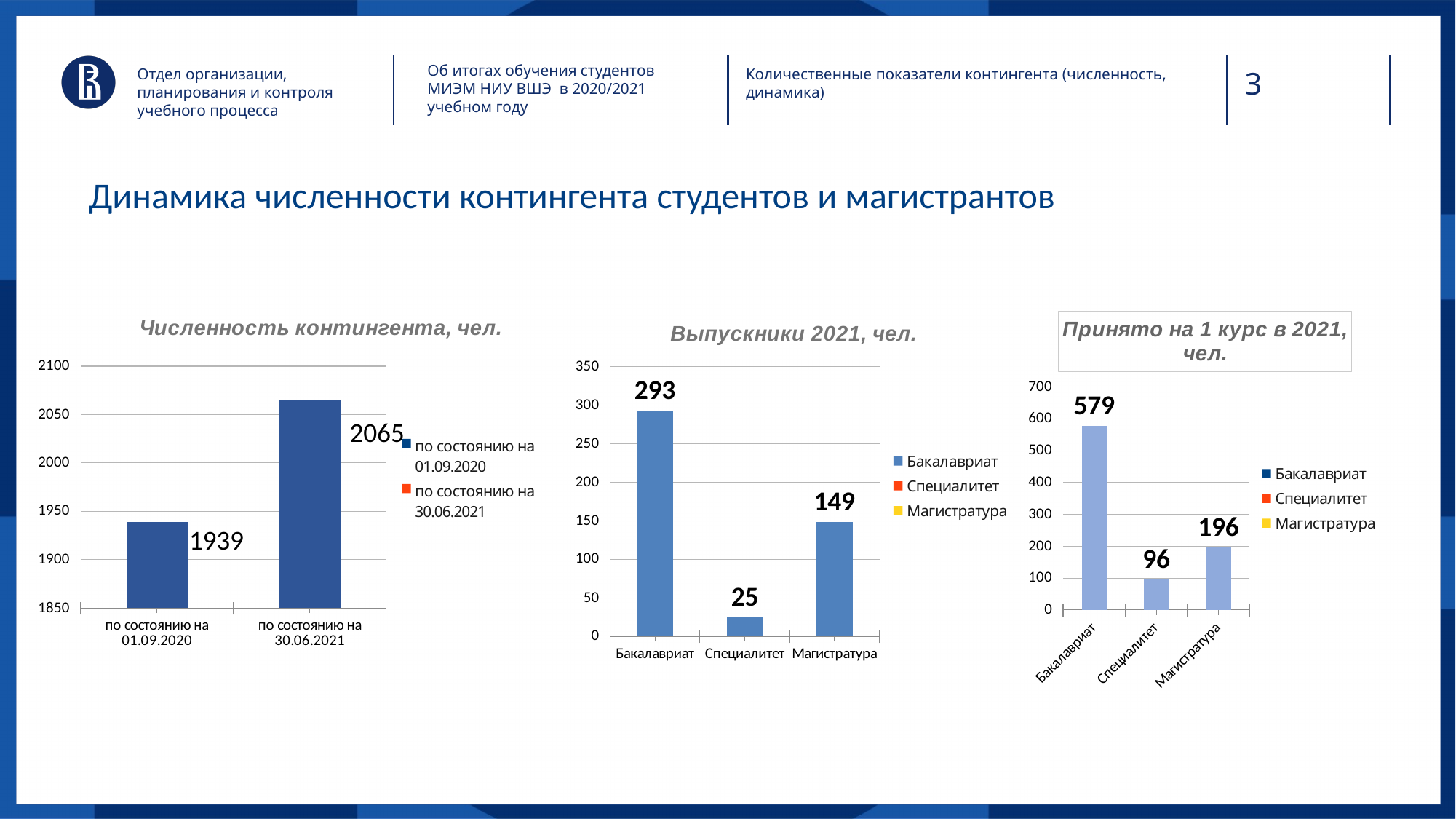
In the chart 'Принято на 1 курс в 2021, чел.', which category has the highest value? Бакалавриат In the chart 'Численность контингента, чел.', do the values rise or fall from 01.09.2020 to 30.06.2021? rise In the chart 'Численность контингента, чел.', what is the value for 'по состоянию на 30.06.2021'? 2065 In the chart 'Принято на 1 курс в 2021, чел.', how many entries does the legend list? 3 In the chart 'Выпускники 2021, чел.', which category has the lowest value? Специалитет In the chart 'Выпускники 2021, чел.', what is the value for Магистратура? 149 In the chart 'Принято на 1 курс в 2021, чел.', which is larger: Магистратура or Специалитет? Магистратура In the chart 'Выпускники 2021, чел.', what is the difference between Бакалавриат and Магистратура? 144 In the chart 'Численность контингента, чел.', what is the difference between the values for 30.06.2021 and 01.09.2020? 126 In the chart 'Принято на 1 курс в 2021, чел.', what is the value for Специалитет? 96 In the chart 'Выпускники 2021, чел.', how many categories are shown on the x axis? 3 What kind of chart is 'Выпускники 2021, чел.'? bar chart